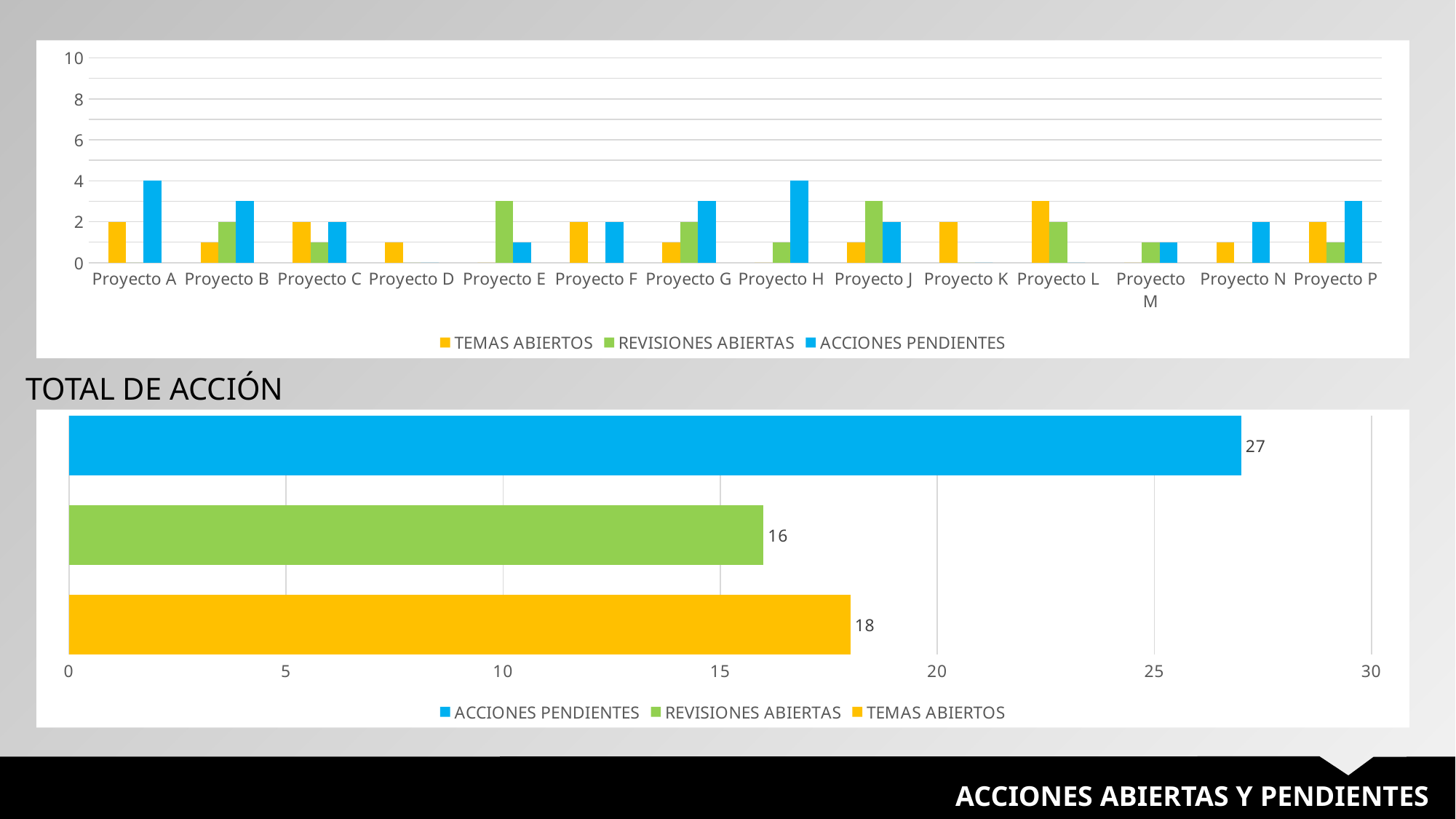
In the top chart, is the value of REVISIONES ABIERTAS for Proyecto E greater or less than 2? greater What kind of chart is the bottom chart titled TOTAL DE ACCIÓN? Bar chart In the bottom chart titled TOTAL DE ACCIÓN, what is the value for REVISIONES ABIERTAS? 16 In the bottom chart titled TOTAL DE ACCIÓN, what is the difference between ACCIONES PENDIENTES and TEMAS ABIERTOS? 9 In the bottom chart titled TOTAL DE ACCIÓN, which category has the highest value? ACCIONES PENDIENTES In the top chart, what is the value of ACCIONES PENDIENTES for Proyecto A? 4 In the bottom chart titled TOTAL DE ACCIÓN, what is the value for ACCIONES PENDIENTES? 27 In the top chart, how many projects are shown on the x axis? 14 In the bottom chart titled TOTAL DE ACCIÓN, which is larger, TEMAS ABIERTOS or REVISIONES ABIERTAS? TEMAS ABIERTOS In the top chart, which colour represents TEMAS ABIERTOS? Yellow In the top chart, how many series does the legend list? 3 In the bottom chart titled TOTAL DE ACCIÓN, which category has the lowest value? REVISIONES ABIERTAS